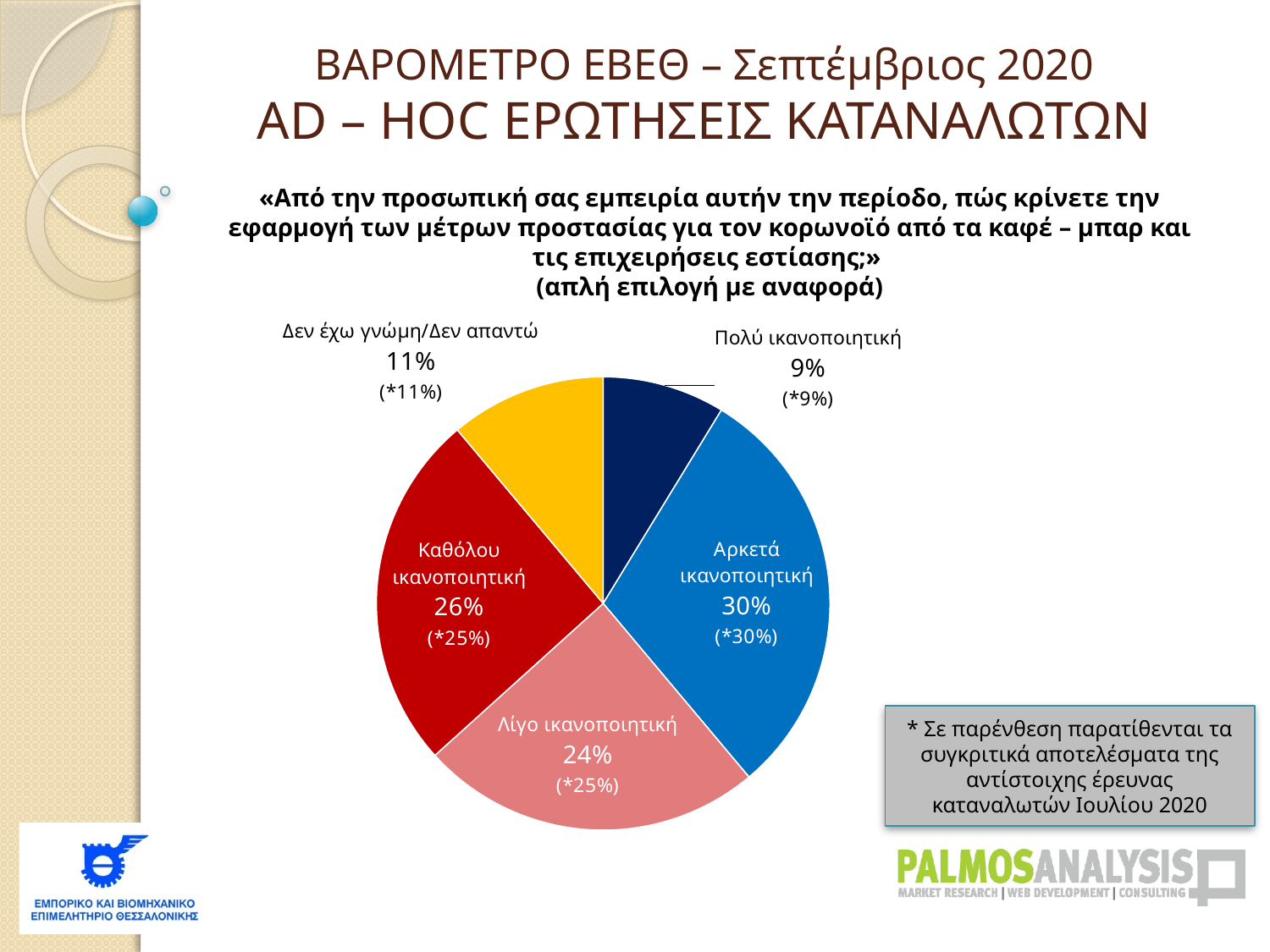
How many slices does the pie chart have? 5 What is the combined share of «Πολύ ικανοποιητική» and «Αρκετά ικανοποιητική»? 39% What was the July 2020 comparison value (in parentheses) for «Λίγο ικανοποιητική»? *25% What percentage of respondents answered «Καθόλου ικανοποιητική»? 26% Which is larger, the share for «Δεν έχω γνώμη/Δεν απαντώ» or the share for «Πολύ ικανοποιητική»? Δεν έχω γνώμη/Δεν απαντώ What percentage of respondents answered «Πολύ ικανοποιητική»? 9% What percentage of respondents answered «Αρκετά ικανοποιητική»? 30% What colour is the slice for «Καθόλου ικανοποιητική»? Red What type of chart is shown on the slide? Pie chart What is the difference in percentage points between «Καθόλου ικανοποιητική» and «Λίγο ικανοποιητική»? 2 percentage points Which response category has the largest share of the pie? Αρκετά ικανοποιητική Which response category has the smallest share of the pie? Πολύ ικανοποιητική